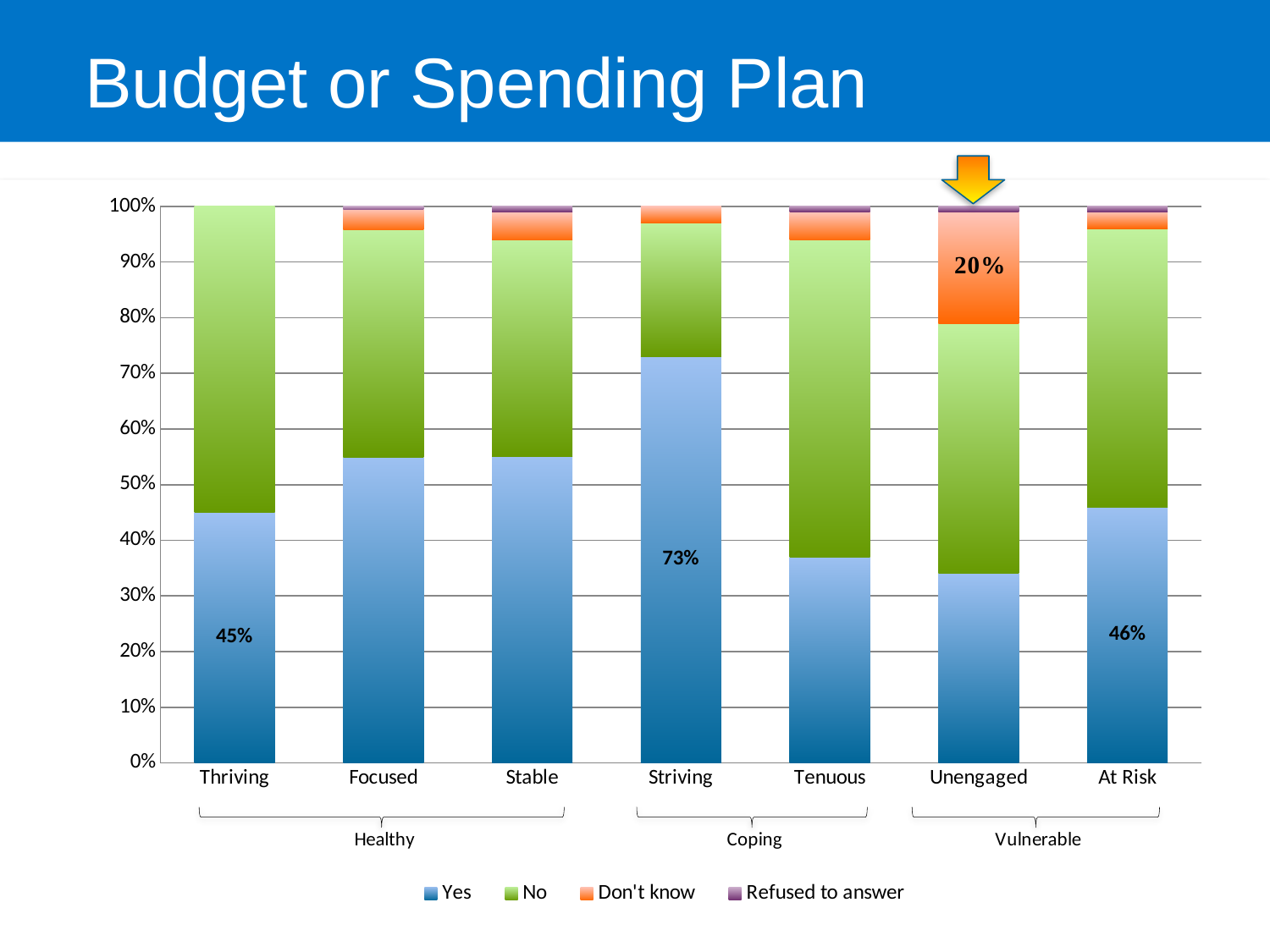
What is the value of the Yes segment for Striving? 73% What is the value of the Yes segment for Thriving? 45% Which category has the highest Yes value? Striving Which has the larger Yes value, Thriving or At Risk? At Risk How many categories are shown on the x axis? 7 What is the value of the Don't know segment for Unengaged? 20% What is the value of the Yes segment for At Risk? 46% Is the Yes value for Tenuous greater or less than 40%? less How many series does the legend list? 4 What kind of chart is shown on the slide? Stacked bar chart What is the difference between the Yes values for Striving and Thriving? 28% Is the Yes value for Focused greater or less than 50%? greater